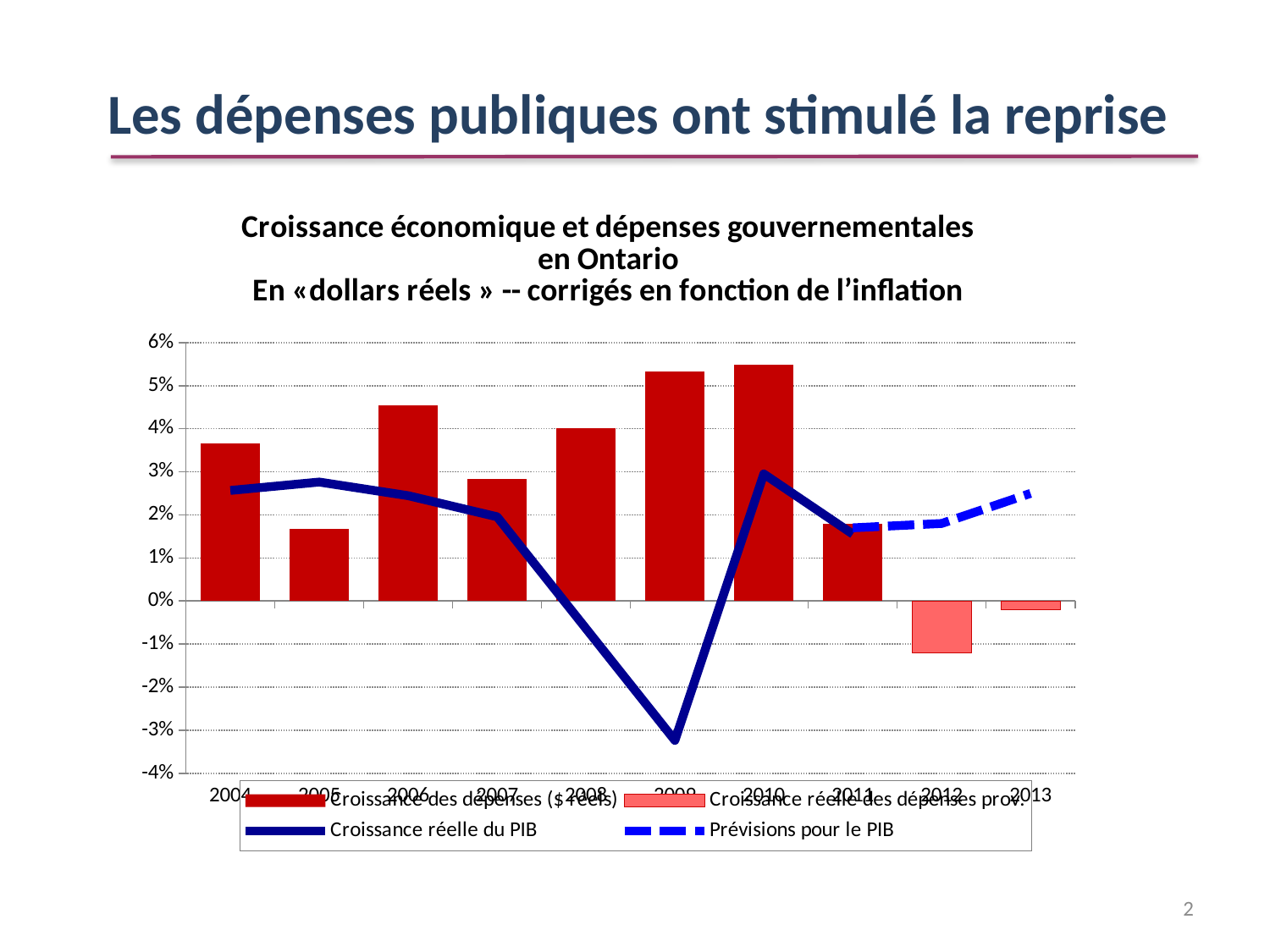
Does the real GDP growth line rise or fall from 2008 to 2009? fall Which is larger, the spending growth bar for 2004 or for 2005? 2004 Is the spending growth bar for 2009 greater or less than 5%? greater Is the spending growth bar for 2006 greater or less than 4%? greater Which legend entry is drawn as a dashed blue line? Prévisions pour le PIB Is the real GDP growth value for 2009 greater or less than -3%? less How many years are shown on the x axis? 10 Which year has the lowest bar for spending growth? 2012 How many series does the legend list? 4 What kind of chart is shown on the slide? A combined bar and line chart In which year does the real GDP growth line reach its lowest point? 2009